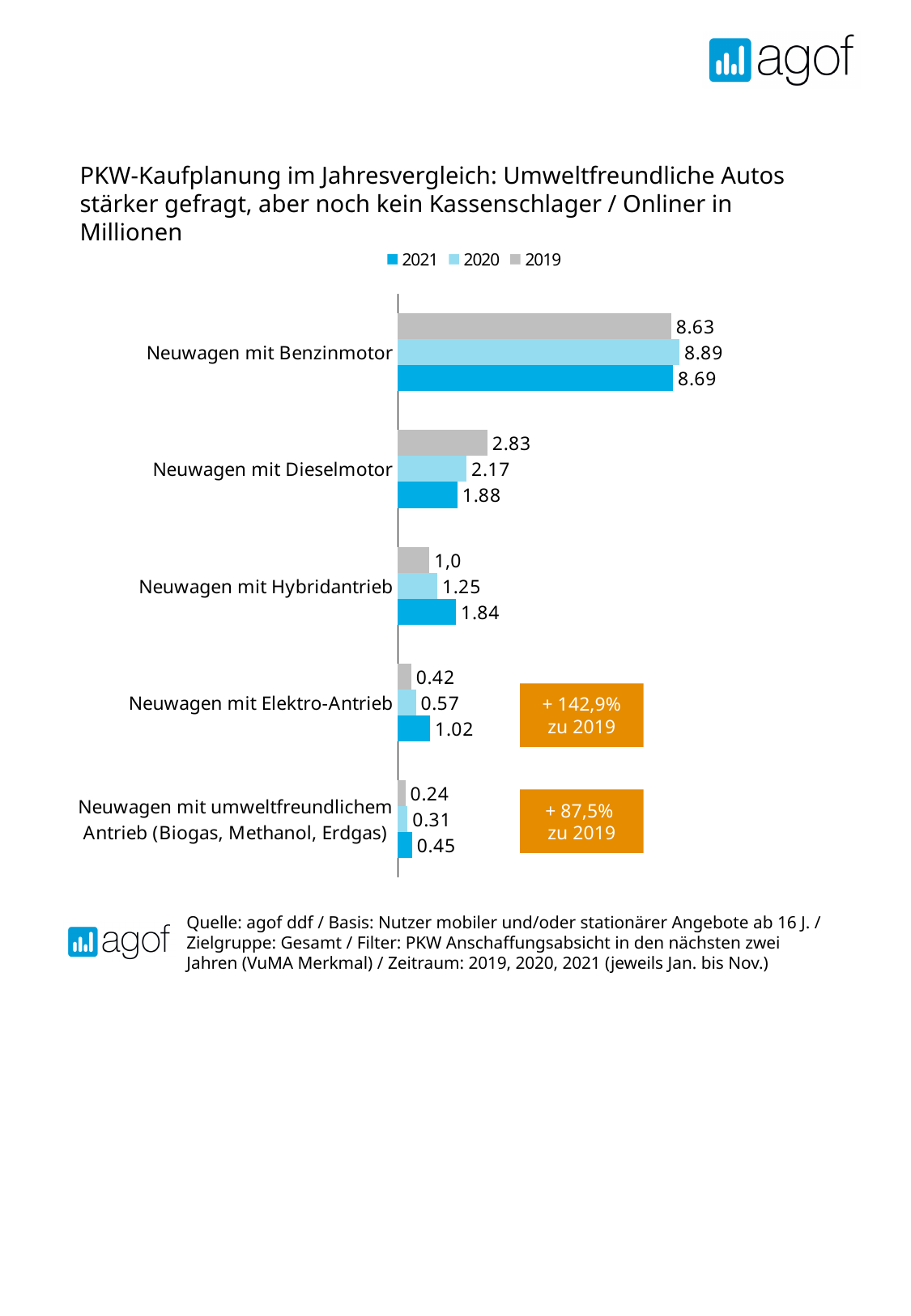
Which is larger for Neuwagen mit Hybridantrieb: the 2021 value or the 2020 value? 2021 How many categories are shown in the chart? 5 Which category has the highest 2021 value? Neuwagen mit Benzinmotor What kind of chart is shown on the slide? Bar chart What is the 2021 value for Neuwagen mit Elektro-Antrieb? 1.02 What is the 2019 value for Neuwagen mit Dieselmotor? 2.83 How many series does the legend list? 3 Which category has the lowest 2019 value? Neuwagen mit umweltfreundlichem Antrieb (Biogas, Methanol, Erdgas) What is the 2020 value for Neuwagen mit Hybridantrieb? 1.25 What percentage change to 2019 is shown in the orange box next to Neuwagen mit Elektro-Antrieb? + 142,9% What is the 2021 value for Neuwagen mit Benzinmotor? 8.69 What is the difference between the 2019 and 2021 values for Neuwagen mit Dieselmotor? 0.95